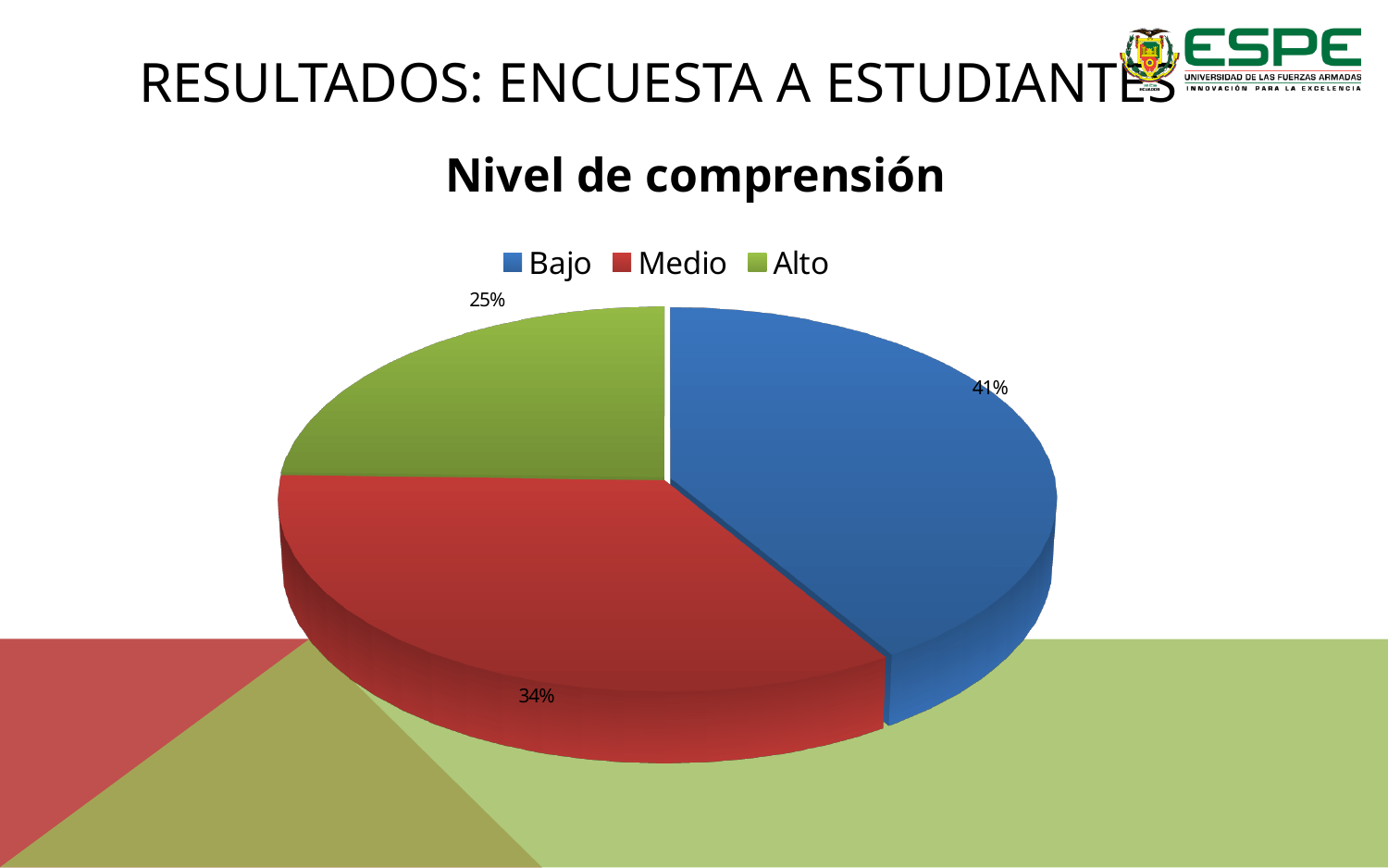
What share of the pie does Bajo represent? 41% What share of the pie does Alto represent? 25% What is the title of the chart? Nivel de comprensión What is the difference in percentage points between Bajo and Alto? 16 Which category has the smallest slice of the pie? Alto What is the difference in percentage points between Bajo and Medio? 7 What share of the pie does Medio represent? 34% Which colour represents Medio in the chart? Red How many categories are shown in the pie chart? 3 Which category has the largest slice of the pie? Bajo Which is larger, the share for Medio or the share for Alto? Medio What kind of chart is shown on the slide? Pie chart